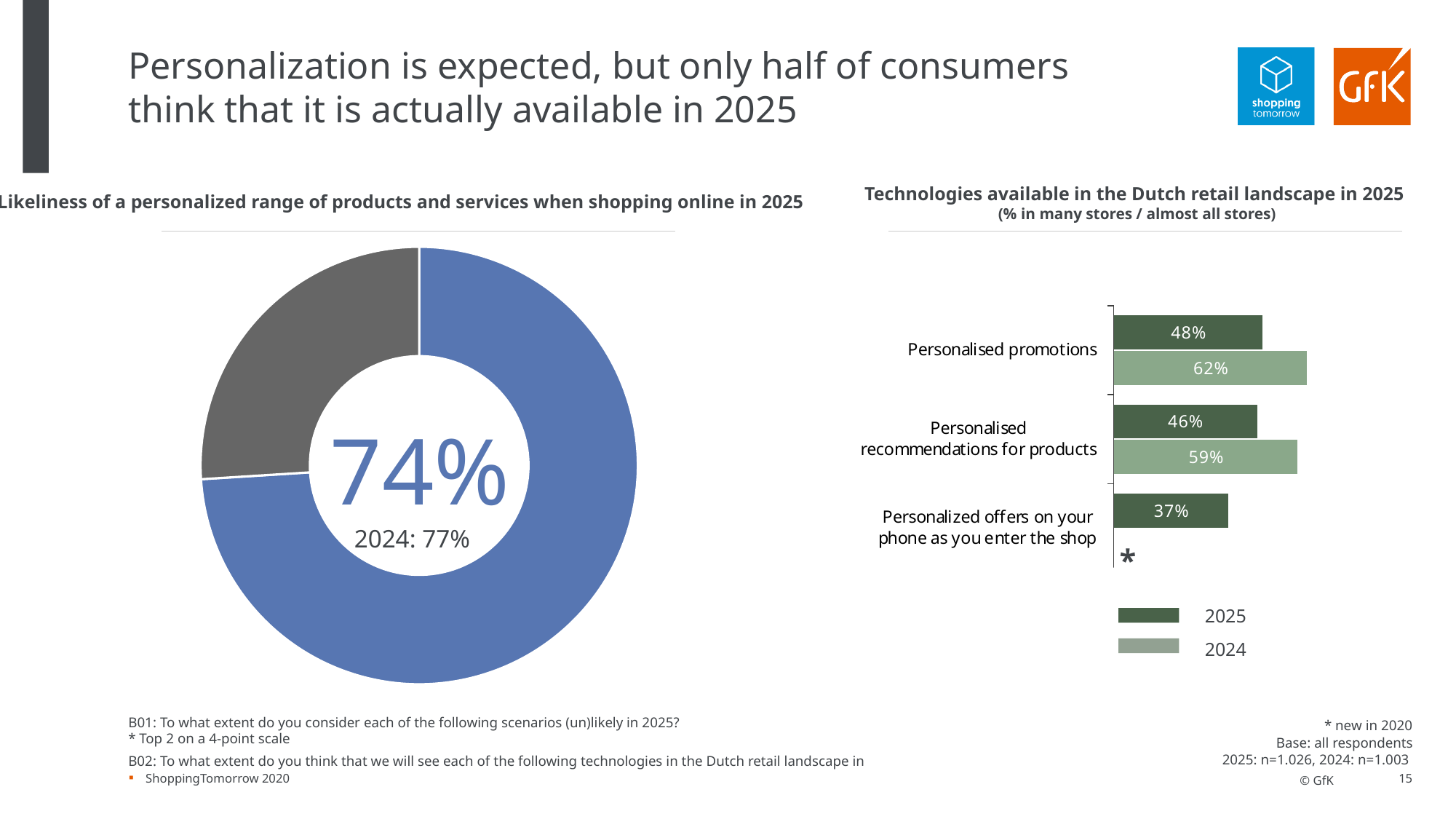
How many series does the legend of the 'Technologies available in the Dutch retail landscape in 2025' chart list? 2 In the 'Technologies available in the Dutch retail landscape in 2025' chart, which is larger for Personalised recommendations for products: the 2025 value or the 2024 value? 2024 In the 'Technologies available in the Dutch retail landscape in 2025' chart, what is the difference between the 2024 and 2025 values for Personalised promotions? 14% In the 'Technologies available in the Dutch retail landscape in 2025' chart, which category has the lowest 2025 value? Personalized offers on your phone as you enter the shop What kind of chart is the 'Technologies available in the Dutch retail landscape in 2025' chart? Bar chart In the 'Technologies available in the Dutch retail landscape in 2025' chart, what is the 2024 value for Personalised recommendations for products? 59% How many categories are shown in the 'Technologies available in the Dutch retail landscape in 2025' chart? 3 In the 'Technologies available in the Dutch retail landscape in 2025' chart, which category has the highest 2024 value? Personalised promotions In the 'Likeliness of a personalized range of products and services when shopping online in 2025' chart, what was the value in 2024? 77% In the 'Technologies available in the Dutch retail landscape in 2025' chart, what is the 2025 value for Personalised promotions? 48% In the 'Technologies available in the Dutch retail landscape in 2025' chart, what is the 2025 value for Personalized offers on your phone as you enter the shop? 37% In the 'Likeliness of a personalized range of products and services when shopping online in 2025' chart, what percentage is shown in the centre for 2025? 74%